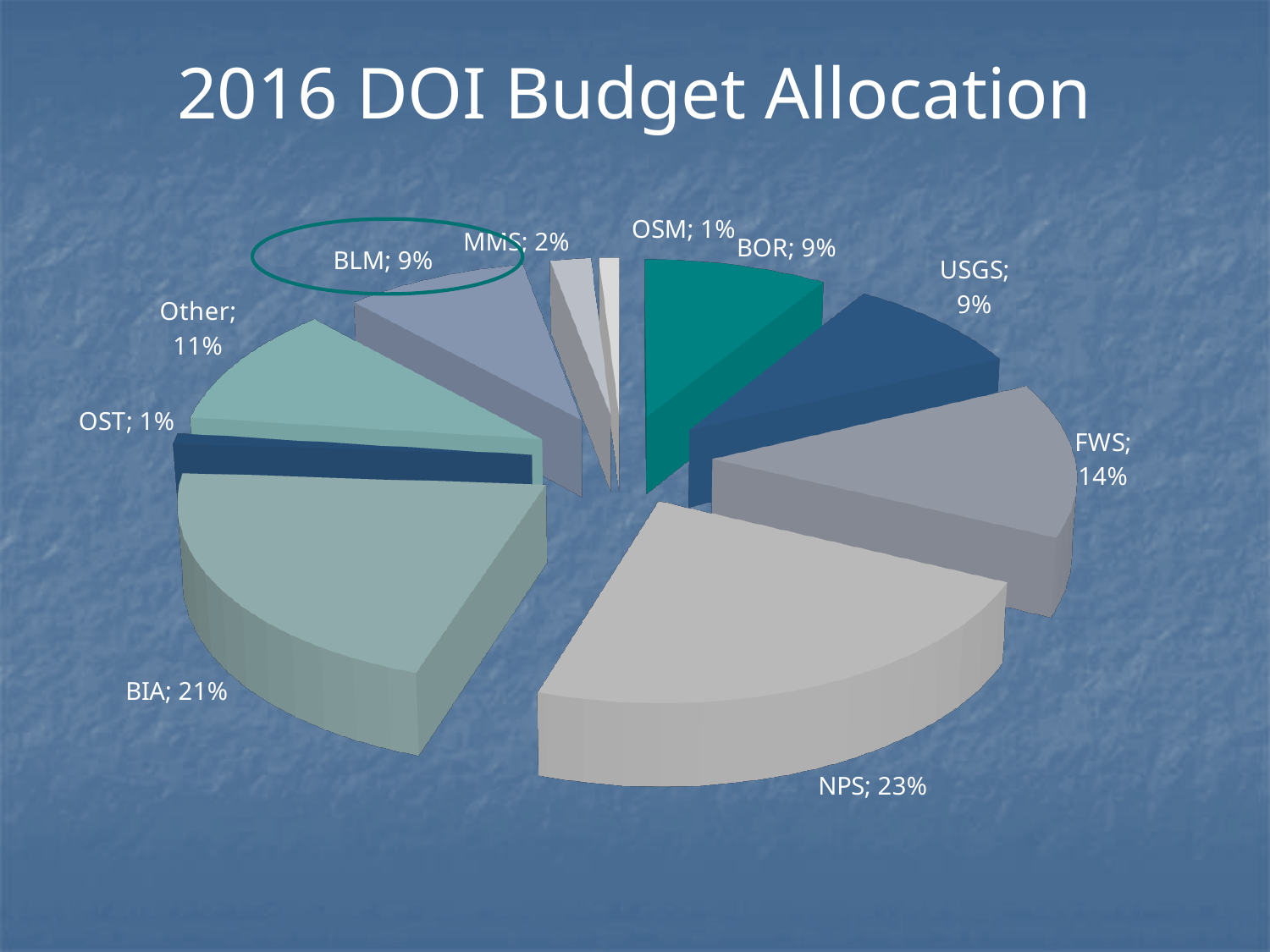
What share of the budget goes to BIA? 21% What percentage is shown for MMS? 2% Which has a larger share, BIA or FWS? BIA What percentage is shown for Other? 11% What share of the 2016 DOI budget is allocated to NPS? 23% What percentage is shown for FWS? 14% What is the difference in percentage points between NPS and BIA? 2% What kind of chart is shown on the slide? pie chart Which slice label is circled on the slide? BLM; 9% How many slices does the pie chart have? 10 What is the title of the chart? 2016 DOI Budget Allocation Which category has the largest share of the budget? NPS